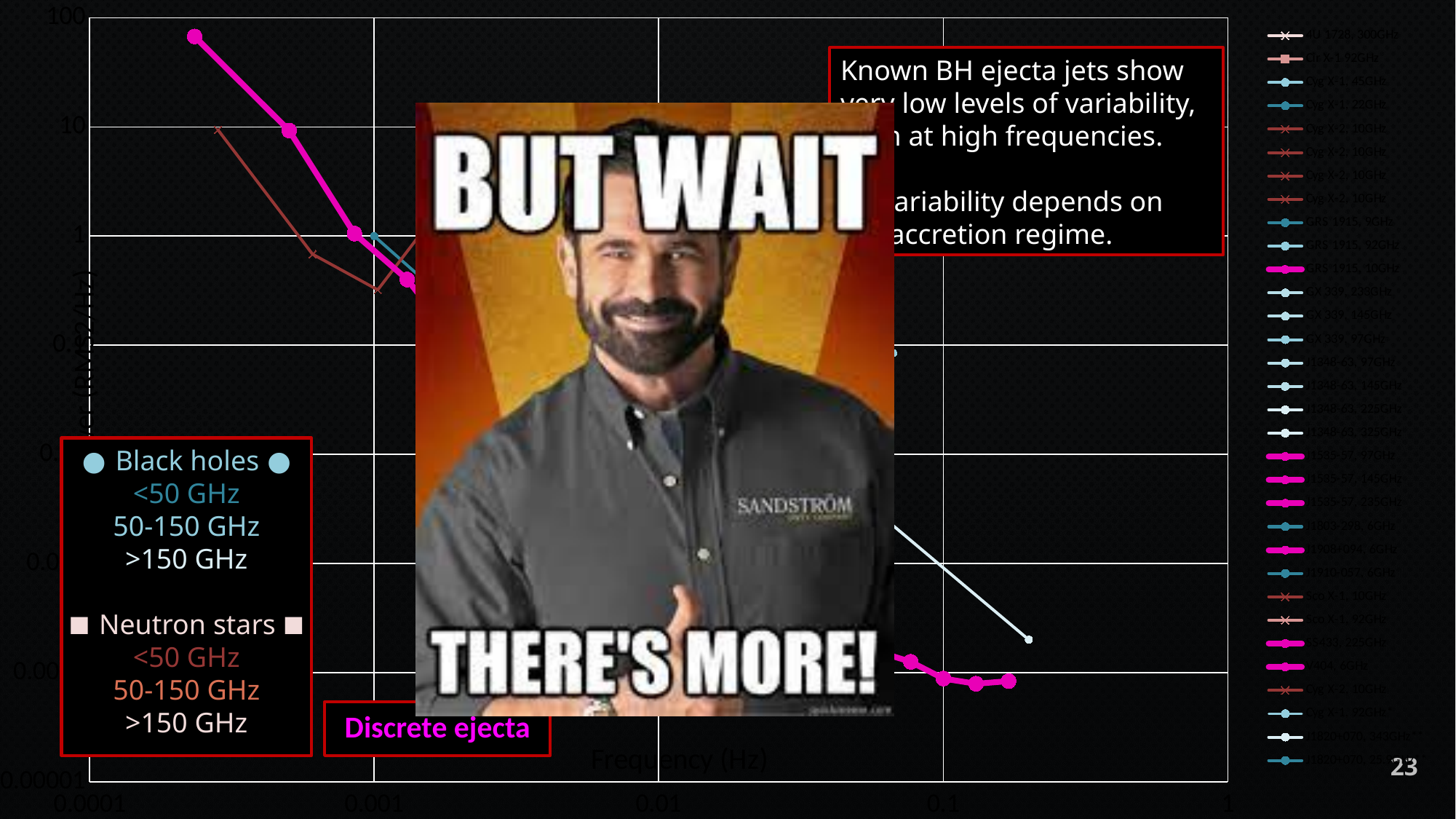
Is the value of the leftmost point on the thick magenta line (near 0.0002 Hz) greater or less than 10? greater What kind of chart is shown on the slide? line chart Are the values of the thick magenta points at the lower right of the chart (between 0.1 and 1 Hz) greater or less than 0.001? less What is the label of the x axis of the chart? Frequency (Hz) Is the value of the leftmost point on the thick magenta line greater or less than 100? less What is the largest value shown on the x axis of the chart? 1 Does the thick magenta line rise or fall as frequency increases along the x axis? fall